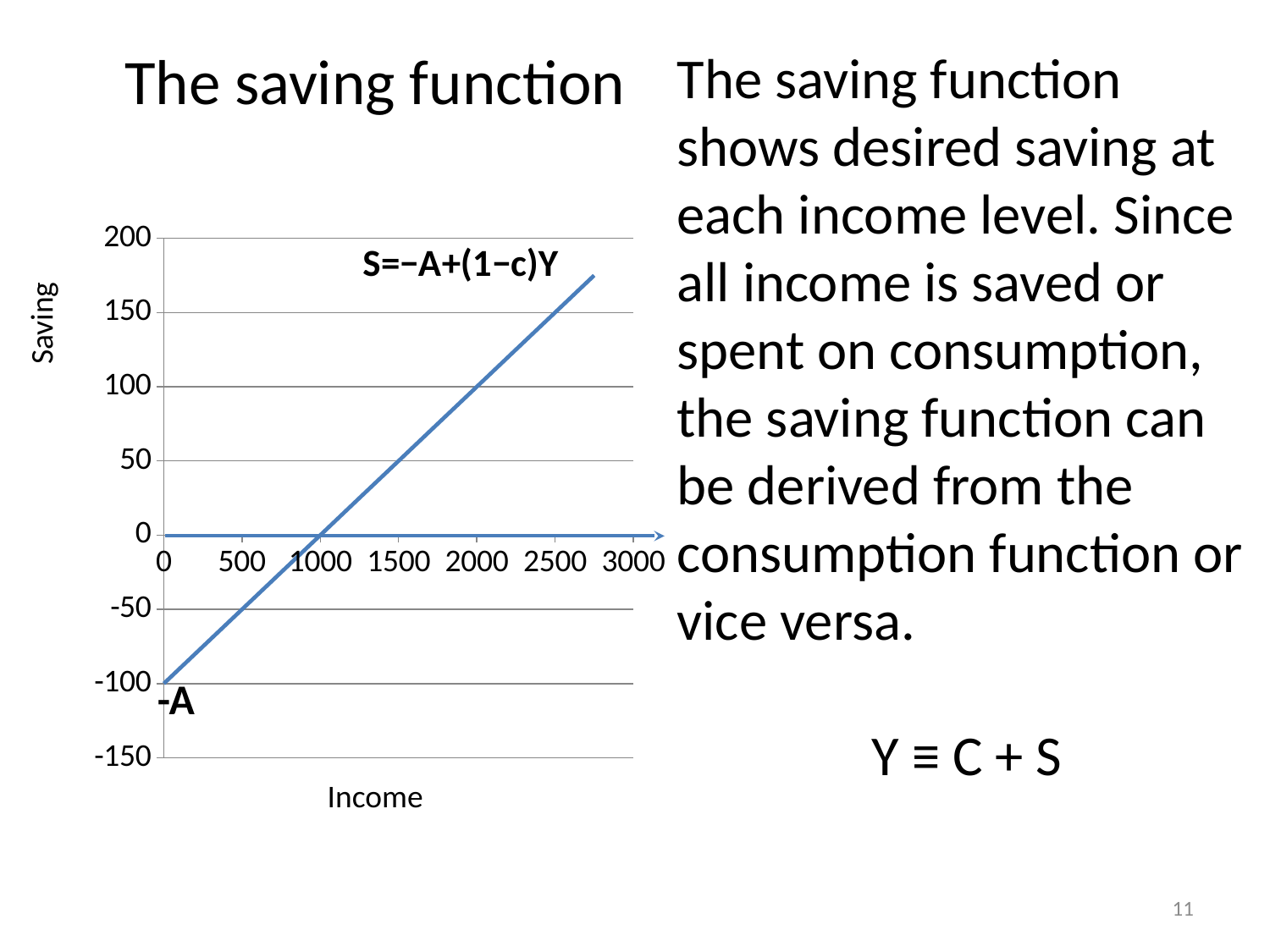
What is the value of saving when income is 0? -100 Is the value of saving at income 500 greater or less than 0? less Does saving rise or fall as income increases along the x axis? rises Is the value of saving at income 1500 greater or less than 100? less At what income level does the saving line cross zero? 1000 Which is larger, saving at income 500 or saving at income 2500? saving at income 2500 What is the label on the vertical axis of the chart? Saving What kind of chart is shown on the slide? line chart What is the value of saving when income is 2000? 100 What is the difference between saving at income 2000 and saving at income 0? 200 What is the value of saving when income is 2500? 150 What is the title of the chart? S=−A+(1−c)Y